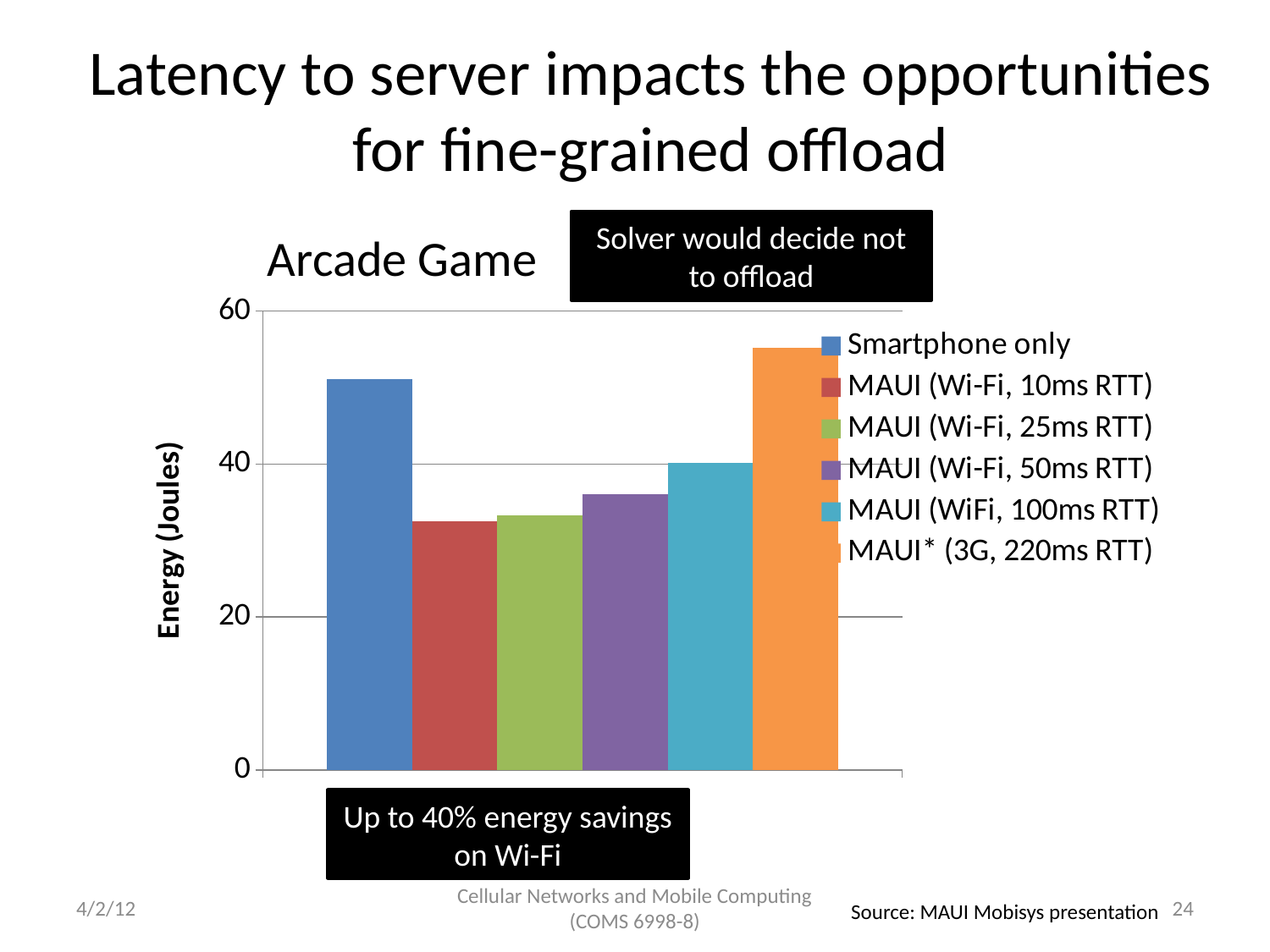
What kind of chart is shown on the slide? bar chart What is the title of the chart? Arcade Game Which series has the highest energy value? MAUI* (3G, 220ms RTT) Do the MAUI Wi-Fi bars rise or fall as the RTT increases from 10ms to 100ms? rise Is the value for MAUI* (3G, 220ms RTT) greater or less than 40? greater Is the value for MAUI (Wi-Fi, 25ms RTT) greater or less than 20? greater Is the value for MAUI (Wi-Fi, 10ms RTT) greater or less than 40? less How many series does the chart legend list? 6 Which is larger, the value for Smartphone only or the value for MAUI (Wi-Fi, 50ms RTT)? Smartphone only What is the label of the y-axis? Energy (Joules)